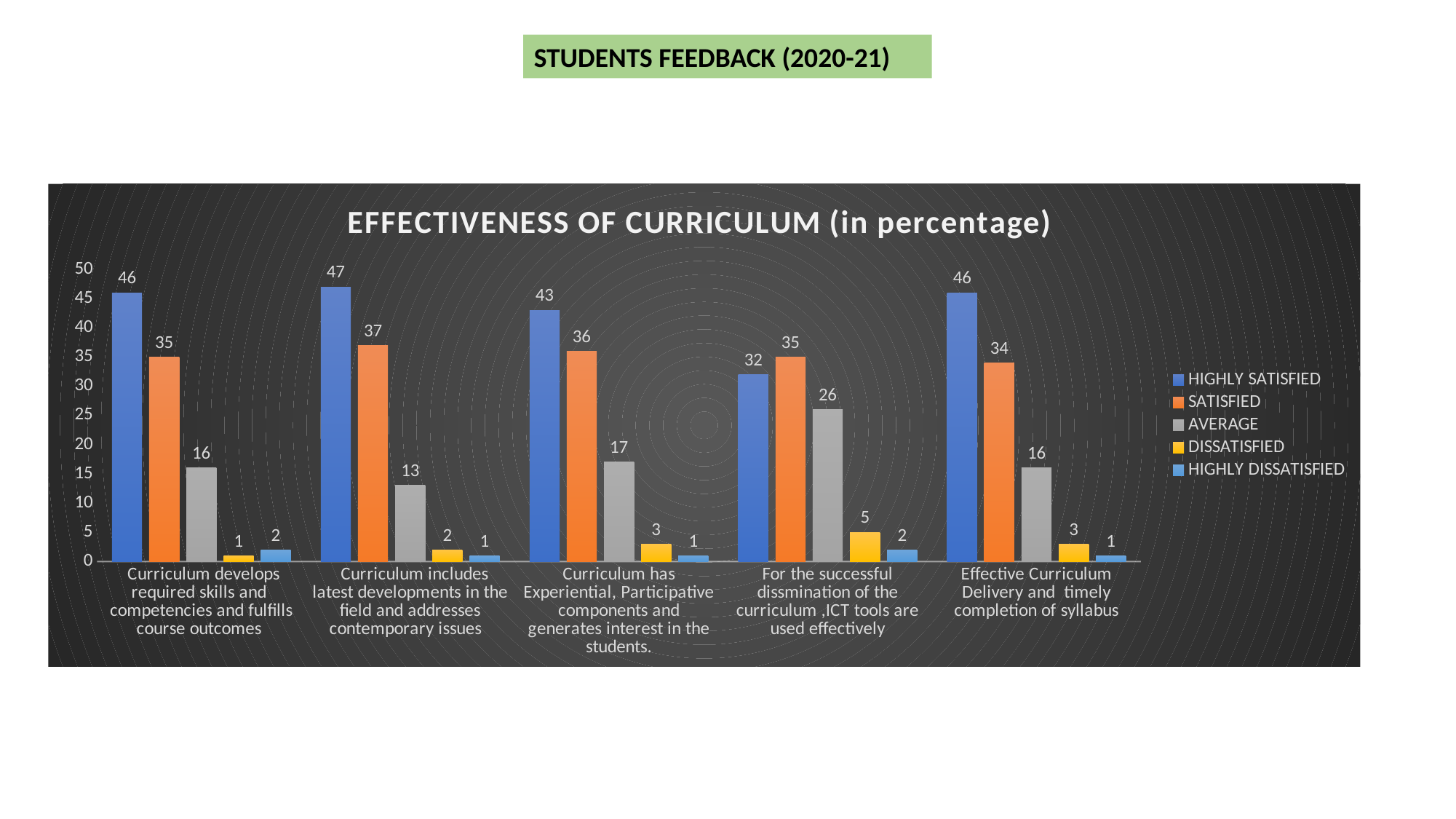
Which is larger for 'For the successful dissmination of the curriculum ,ICT tools are used effectively': HIGHLY SATISFIED or SATISFIED? SATISFIED What is the DISSATISFIED value for 'Effective Curriculum Delivery and timely completion of syllabus'? 3 What is the difference between the SATISFIED and AVERAGE values for 'Curriculum has Experiential, Participative components and generates interest in the students.'? 19 What is the AVERAGE value for 'For the successful dissmination of the curriculum ,ICT tools are used effectively'? 26 Which category has the lowest HIGHLY SATISFIED value? For the successful dissmination of the curriculum ,ICT tools are used effectively What is the title of the chart? EFFECTIVENESS OF CURRICULUM (in percentage) What is the HIGHLY SATISFIED value for 'Curriculum includes latest developments in the field and addresses contemporary issues'? 47 Which series is shown in yellow in the legend? DISSATISFIED How many series does the legend list? 5 Which category has the highest HIGHLY SATISFIED value? Curriculum includes latest developments in the field and addresses contemporary issues What kind of chart is shown on the slide? Bar chart How many categories are shown on the x axis? 5